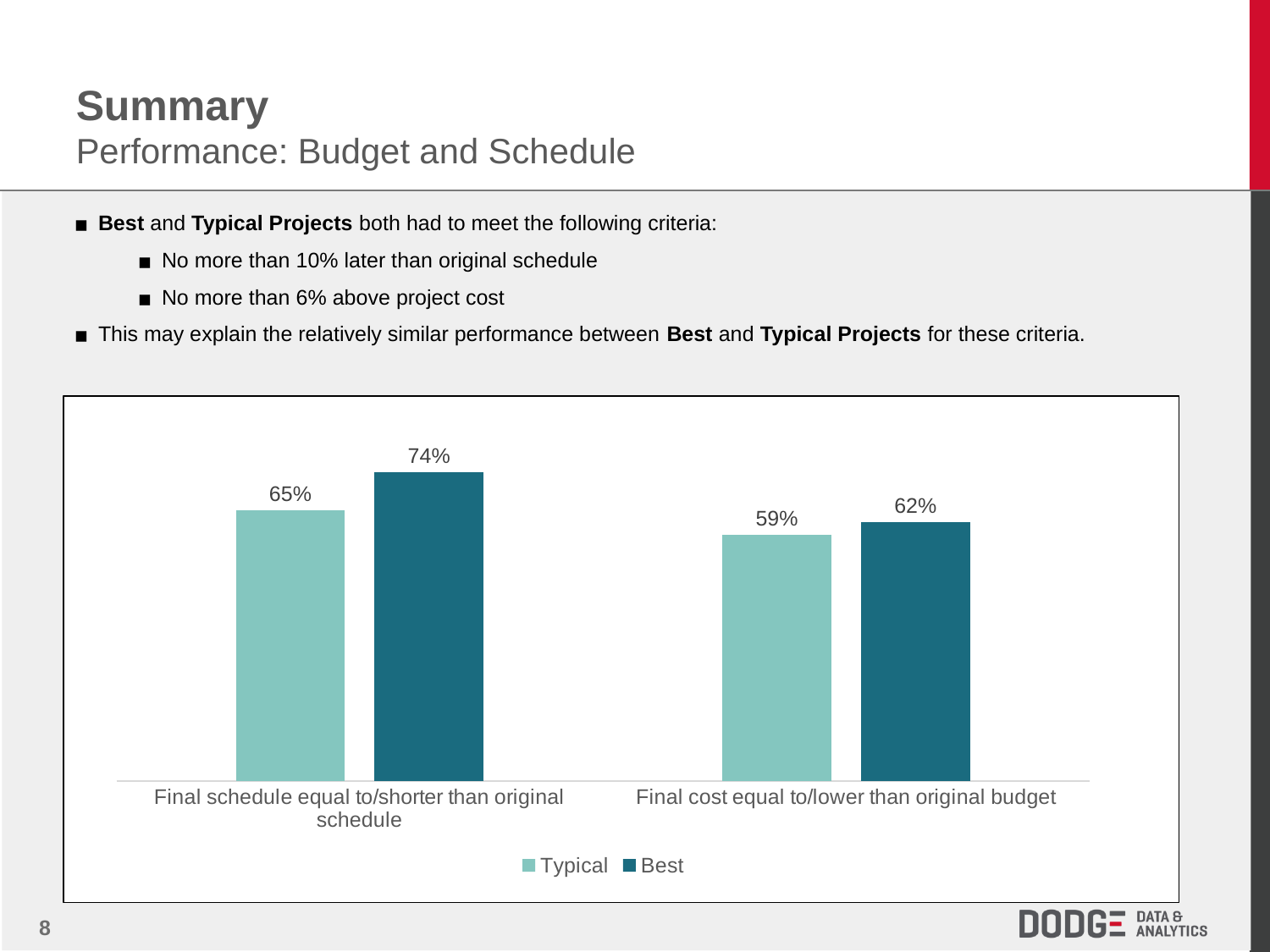
What is the value for Typical projects for 'Final schedule equal to/shorter than original schedule'? 65% Which bar in the chart has the lowest value? Typical, Final cost equal to/lower than original budget What is the value for Best projects for 'Final schedule equal to/shorter than original schedule'? 74% Which bar in the chart has the highest value? Best, Final schedule equal to/shorter than original schedule What is the difference between Best and Typical for 'Final schedule equal to/shorter than original schedule'? 9 percentage points What is the value for Typical projects for 'Final cost equal to/lower than original budget'? 59% What is the difference between Best and Typical for 'Final cost equal to/lower than original budget'? 3 percentage points For 'Final cost equal to/lower than original budget', which is larger: Typical or Best? Best What kind of chart is shown on the slide? Bar chart What is the value for Best projects for 'Final cost equal to/lower than original budget'? 62% How many series does the chart's legend list? 2 How many categories are shown on the x axis of the chart? 2